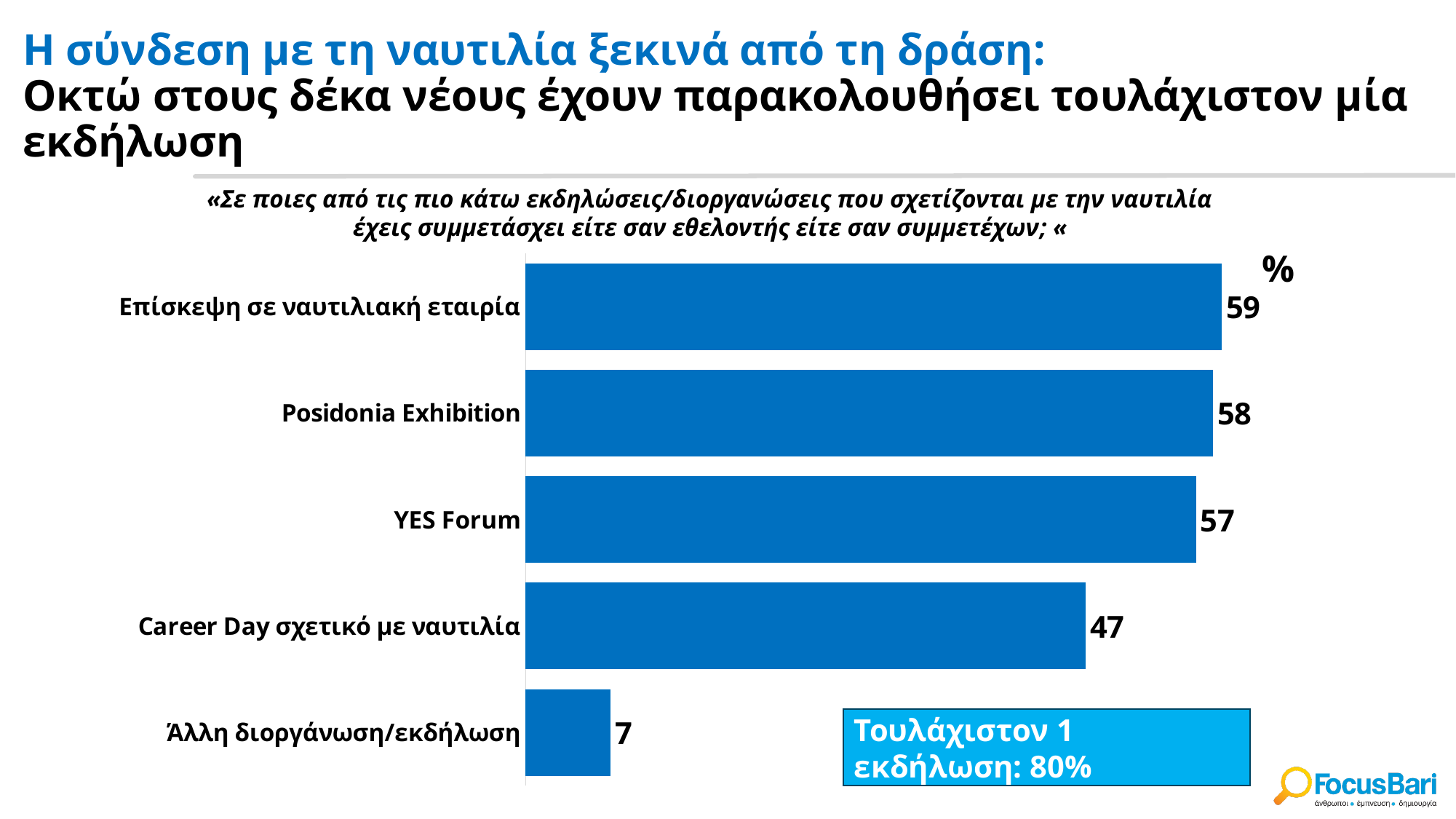
What is the value for Career Day σχετικό με ναυτιλία? 47 Which category has the highest value? Επίσκεψη σε ναυτιλιακή εταιρία What is the value for Posidonia Exhibition? 58 What percentage is given in the highlighted box for attending at least one event (Τουλάχιστον 1 εκδήλωση)? 80% What is the difference between the values for Επίσκεψη σε ναυτιλιακή εταιρία and Career Day σχετικό με ναυτιλία? 12 How many categories are shown in the chart? 5 What is the value for YES Forum? 57 What is the value for Άλλη διοργάνωση/εκδήλωση? 7 What is the difference between the values for YES Forum and Άλλη διοργάνωση/εκδήλωση? 50 What kind of chart is shown on the slide? Bar chart Which is larger, the value for Posidonia Exhibition or the value for Career Day σχετικό με ναυτιλία? Posidonia Exhibition Which category has the lowest value? Άλλη διοργάνωση/εκδήλωση